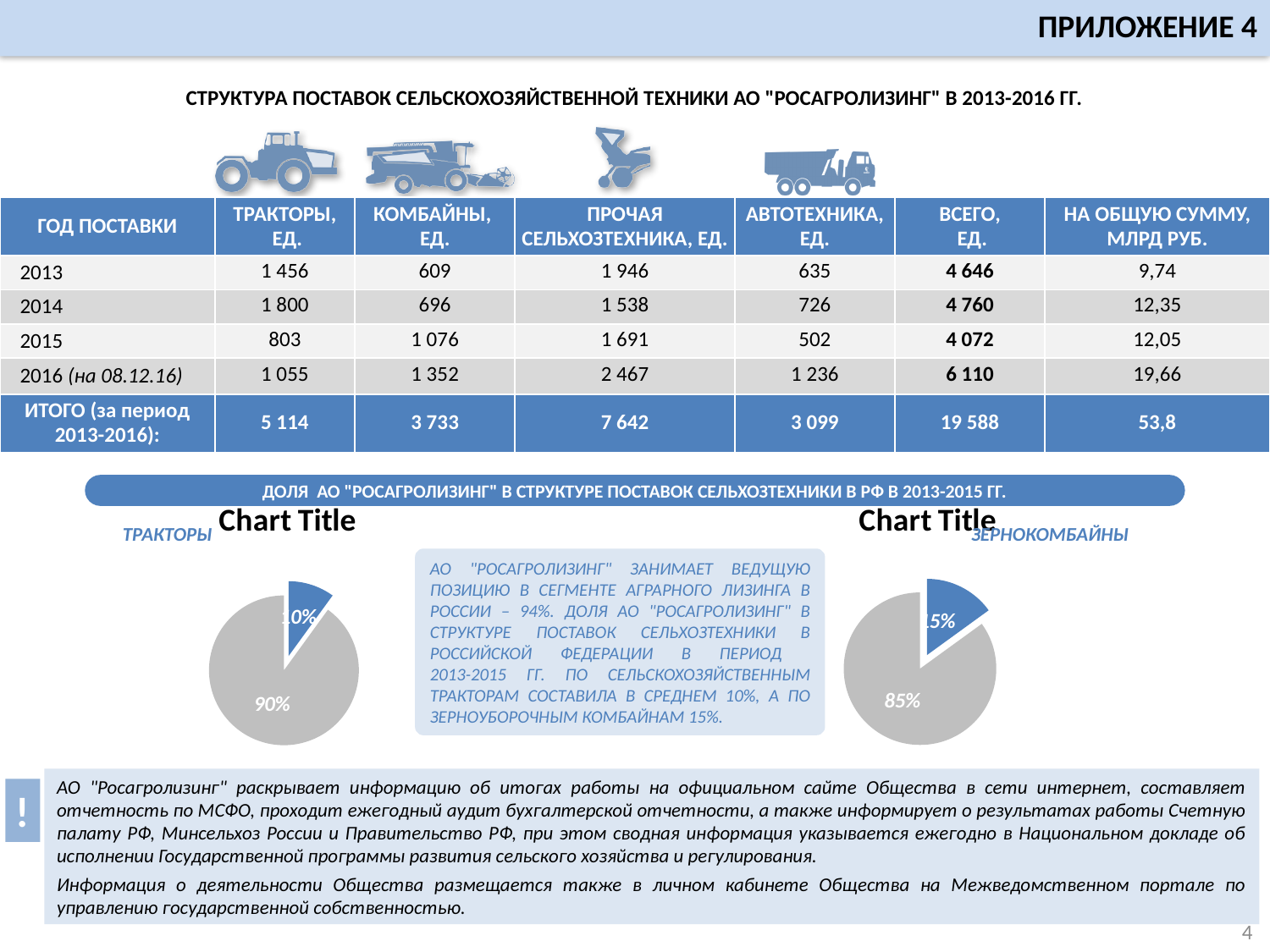
In the left pie chart (ТРАКТОРЫ), what share does the blue slice show? 10% In the left pie chart (ТРАКТОРЫ), what share does the grey slice show? 90% What kind of chart is the left chart labelled ТРАКТОРЫ? pie chart What title text is displayed above each of the two pie charts? Chart Title Which is larger: the blue slice in the ТРАКТОРЫ pie chart or the blue slice in the ЗЕРНОКОМБАЙНЫ pie chart? the blue slice in the ЗЕРНОКОМБАЙНЫ pie chart In the left pie chart (ТРАКТОРЫ), which slice is larger, the blue one or the grey one? the grey one In the right pie chart (ЗЕРНОКОМБАЙНЫ), what share does the grey slice show? 85% How many slices does the right pie chart (ЗЕРНОКОМБАЙНЫ) have? 2 How many slices does the left pie chart (ТРАКТОРЫ) have? 2 What kind of chart is the right chart labelled ЗЕРНОКОМБАЙНЫ? pie chart What is the difference between the grey slice and the blue slice in the right pie chart (ЗЕРНОКОМБАЙНЫ)? 70%